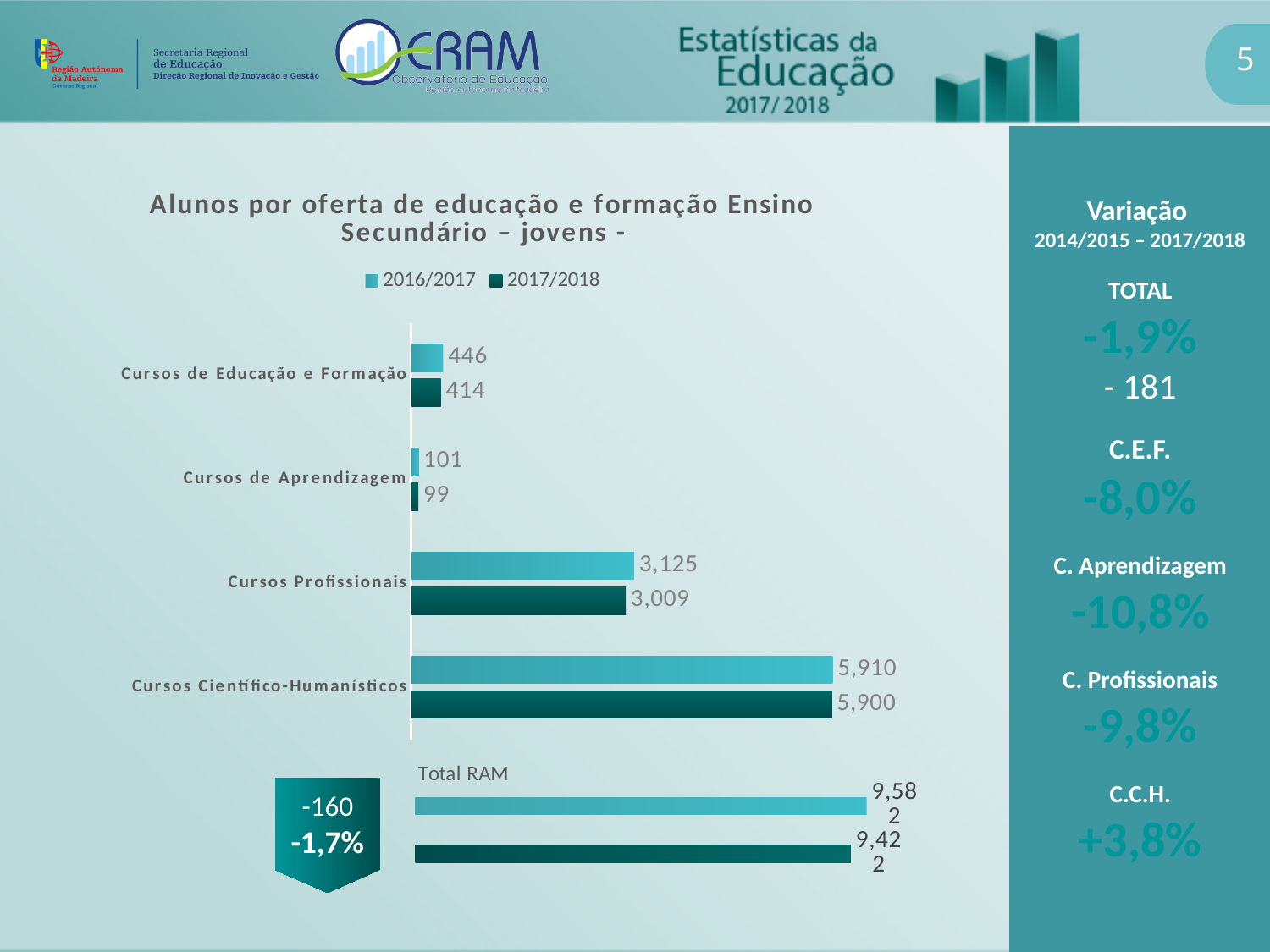
In the chart 'Alunos por oferta de educação e formação Ensino Secundário – jovens -', what is the difference between the 2016/2017 and 2017/2018 values for Cursos de Educação e Formação? 32 In the chart 'Alunos por oferta de educação e formação Ensino Secundário – jovens -', what is the difference between the 2016/2017 and 2017/2018 values for Cursos Profissionais? 116 In the chart 'Alunos por oferta de educação e formação Ensino Secundário – jovens -', what is the value for Cursos de Aprendizagem in 2017/2018? 99 In the chart 'Alunos por oferta de educação e formação Ensino Secundário – jovens -', what is the value for Cursos Científico-Humanísticos in 2016/2017? 5,910 In the chart 'Alunos por oferta de educação e formação Ensino Secundário – jovens -', what is the value for Cursos Profissionais in 2017/2018? 3,009 How many series does the legend of the chart 'Alunos por oferta de educação e formação Ensino Secundário – jovens -' list? 2 In the chart 'Alunos por oferta de educação e formação Ensino Secundário – jovens -', which is larger for Cursos Científico-Humanísticos: the 2016/2017 value or the 2017/2018 value? 2016/2017 What kind of chart is 'Alunos por oferta de educação e formação Ensino Secundário – jovens -'? Bar chart In the chart 'Alunos por oferta de educação e formação Ensino Secundário – jovens -', what is the value for Cursos de Educação e Formação in 2016/2017? 446 How many categories does the chart 'Alunos por oferta de educação e formação Ensino Secundário – jovens -' show? 4 In the chart 'Alunos por oferta de educação e formação Ensino Secundário – jovens -', which category has the lowest value in 2016/2017? Cursos de Aprendizagem In the chart 'Alunos por oferta de educação e formação Ensino Secundário – jovens -', which category has the highest value in 2017/2018? Cursos Científico-Humanísticos